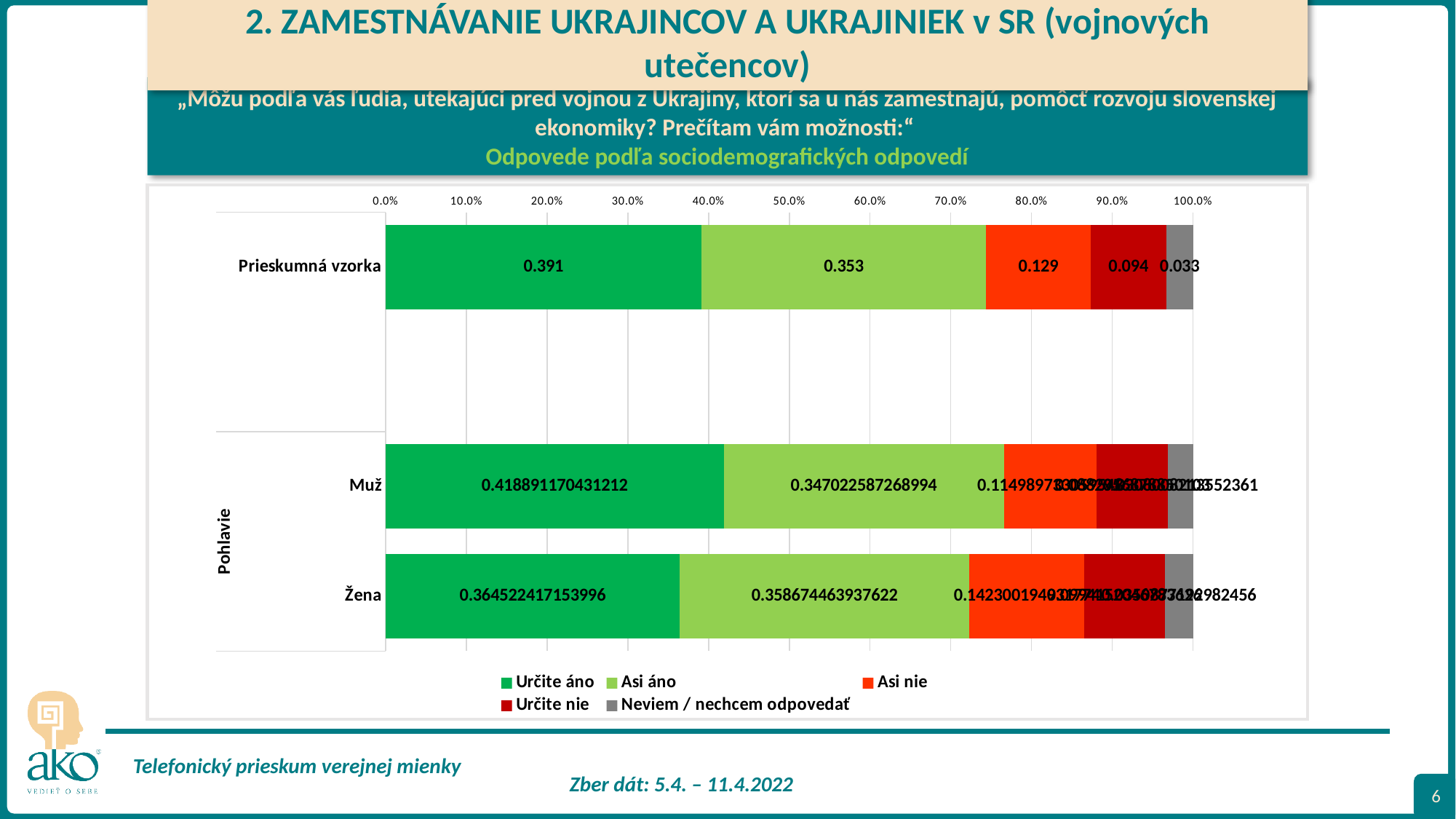
What is the value of 'Asi áno' for 'Prieskumná vzorka'? 0.353 What is the difference between the 'Určite áno' and 'Asi áno' values for 'Prieskumná vzorka'? 0.038 What kind of chart is shown on the slide? stacked bar chart What is the value of 'Určite nie' for 'Prieskumná vzorka'? 0.094 Which category has the highest value for 'Určite áno'? Muž What is the value of 'Asi áno' for 'Žena'? 0.358674463937622 How many series does the legend list? 5 What is the value of 'Určite áno' for 'Prieskumná vzorka'? 0.391 What is the value of 'Určite áno' for 'Muž'? 0.418891170431212 What is the value of 'Neviem / nechcem odpovedať' for 'Prieskumná vzorka'? 0.033 How many categories (bars) are plotted in the chart? 3 What is the value of 'Asi nie' for 'Prieskumná vzorka'? 0.129